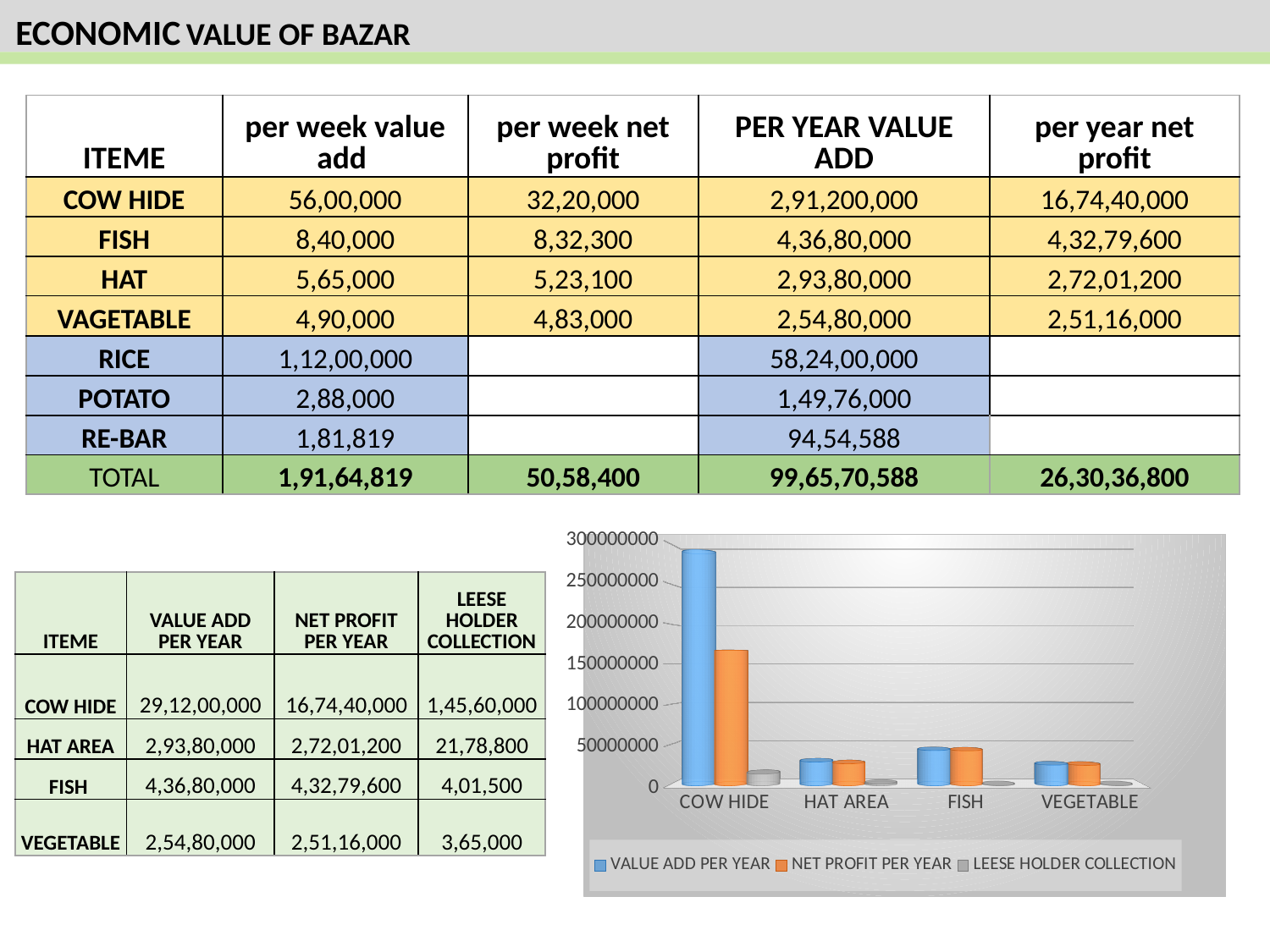
How many series does the chart legend list? 3 Which is larger in the chart, the VALUE ADD PER YEAR bar for FISH or for HAT AREA? FISH Is the VALUE ADD PER YEAR bar for COW HIDE greater or less than 250000000? greater Which category has the highest NET PROFIT PER YEAR bar in the chart? COW HIDE For COW HIDE, which bar is taller: VALUE ADD PER YEAR or NET PROFIT PER YEAR? VALUE ADD PER YEAR Is the VALUE ADD PER YEAR bar for HAT AREA greater or less than 50000000? less Which colour represents the LEESE HOLDER COLLECTION series in the chart legend? grey How many categories are shown on the x axis of the chart? 4 Which category has the highest VALUE ADD PER YEAR bar in the chart? COW HIDE Is the NET PROFIT PER YEAR bar for COW HIDE greater or less than 150000000? greater What kind of chart is shown on the slide? bar chart